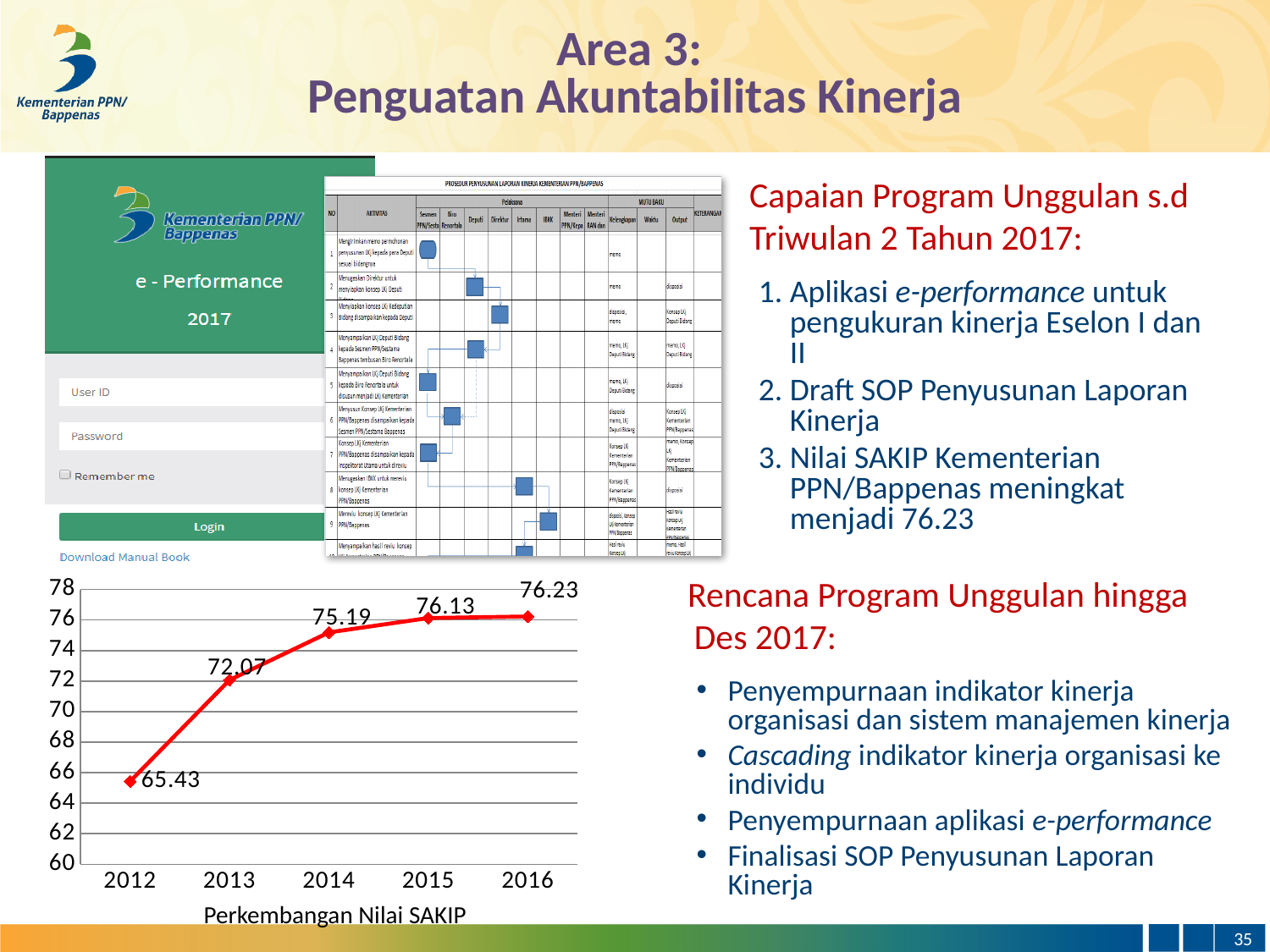
Which year has the lowest value in the Perkembangan Nilai SAKIP chart? 2012 What is the SAKIP value for 2012 in the Perkembangan Nilai SAKIP chart? 65.43 Which year has the highest value in the Perkembangan Nilai SAKIP chart? 2016 Is the value for 2012 in the Perkembangan Nilai SAKIP chart greater or less than 66? less How many years are plotted in the Perkembangan Nilai SAKIP chart? 5 What kind of chart is the Perkembangan Nilai SAKIP chart? line chart What is the SAKIP value for 2014 in the Perkembangan Nilai SAKIP chart? 75.19 What is the difference between the 2013 and 2012 values in the Perkembangan Nilai SAKIP chart? 6.64 What is the difference between the 2016 and 2015 values in the Perkembangan Nilai SAKIP chart? 0.1 Do the values in the Perkembangan Nilai SAKIP chart rise or fall from 2012 to 2016? rise What is the SAKIP value for 2016 in the Perkembangan Nilai SAKIP chart? 76.23 In the Perkembangan Nilai SAKIP chart, which is larger, the value for 2013 or the value for 2014? 2014